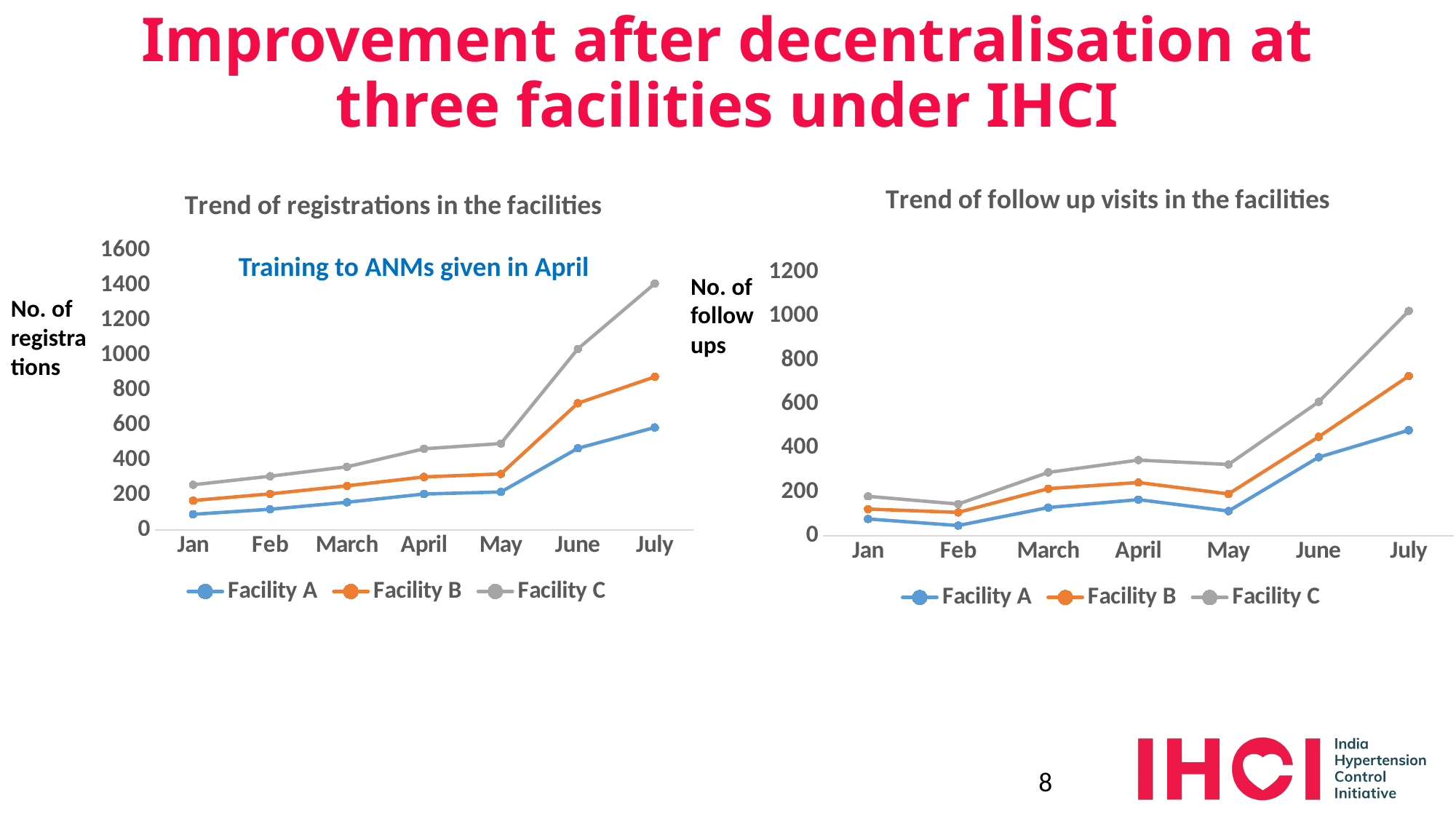
In the 'Trend of registrations in the facilities' chart, which facility has the highest registrations in July? Facility C In the 'Trend of registrations in the facilities' chart, how many series does the legend list? 3 In the 'Trend of follow up visits in the facilities' chart, is the value for Facility A in Feb greater or less than 200? less In the 'Trend of registrations in the facilities' chart, is the value for Facility C in July greater or less than 1200? greater In the 'Trend of follow up visits in the facilities' chart, which is larger in June: Facility B or Facility C? Facility C In the 'Trend of registrations in the facilities' chart, what kind of chart is used? line chart In the 'Trend of follow up visits in the facilities' chart, is the value for Facility C in July greater or less than 800? greater In the 'Trend of registrations in the facilities' chart, how many months are shown on the x axis? 7 In the 'Trend of registrations in the facilities' chart, do the values for Facility C rise or fall from Jan to July? rise In the 'Trend of follow up visits in the facilities' chart, which facility has the lowest follow ups in July? Facility A In the 'Trend of registrations in the facilities' chart, in which month was training to ANMs given according to the annotation? April